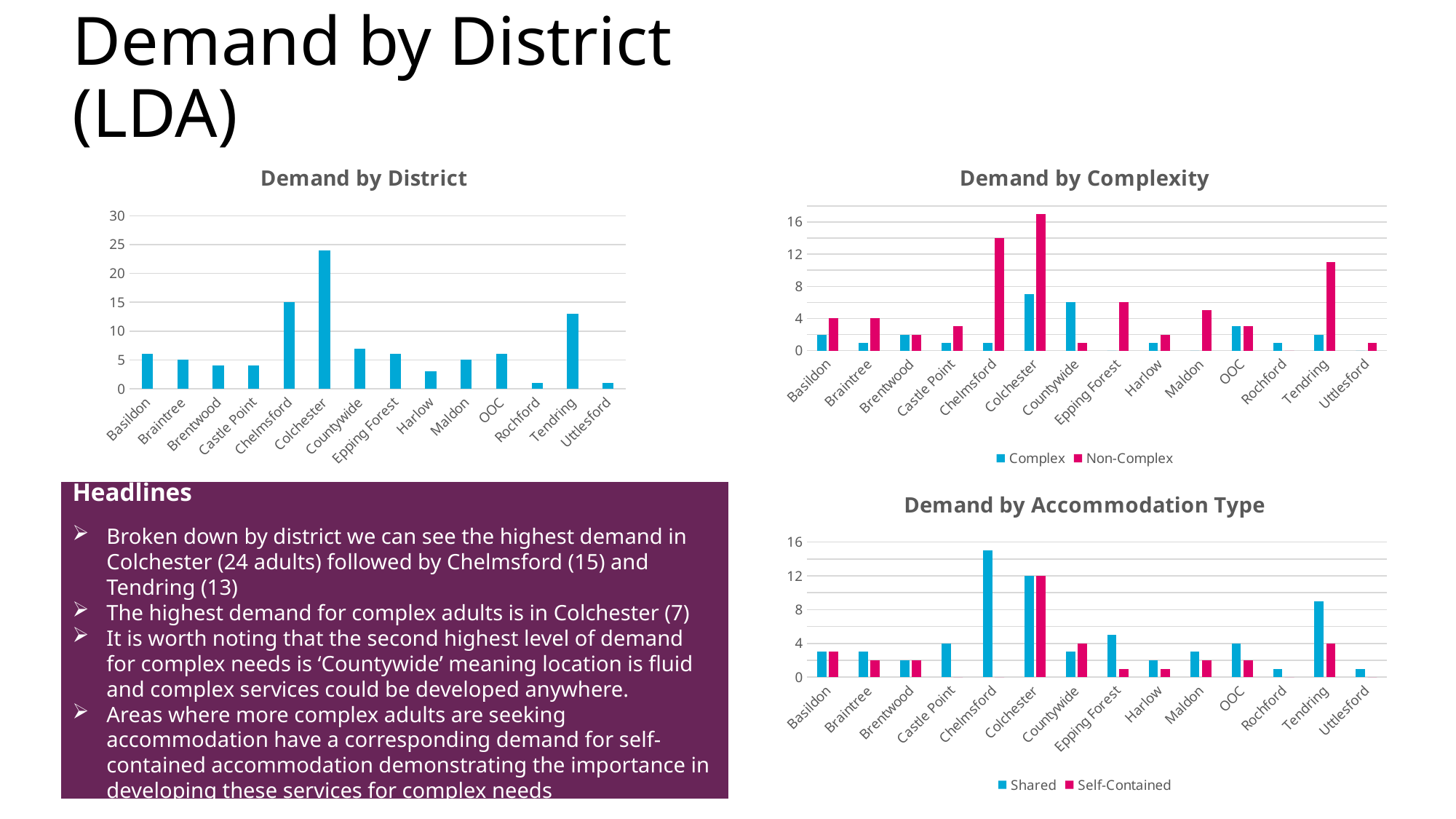
In the Demand by District chart, how many districts are shown on the x axis? 14 In the Demand by District chart, what is the demand for Colchester? 24 In the Demand by District chart, is the value for Rochford greater or less than 5? less What kind of chart is the Demand by District chart? Bar chart In the Demand by Accommodation Type chart, which district has the highest Shared demand? Chelmsford In the Demand by District chart, which is larger, the demand for Chelmsford or for Tendring? Chelmsford In the Demand by District chart, which district has the highest demand? Colchester In the Demand by Complexity chart, what is the Non-Complex value for Basildon? 4 In the Demand by Complexity chart, which district has the highest Non-Complex demand? Colchester How many series does the legend of the Demand by Complexity chart list? 2 In the Demand by Complexity chart, is the Non-Complex value for Tendring greater or less than 8? greater In the Demand by District chart, what is the demand for Chelmsford? 15